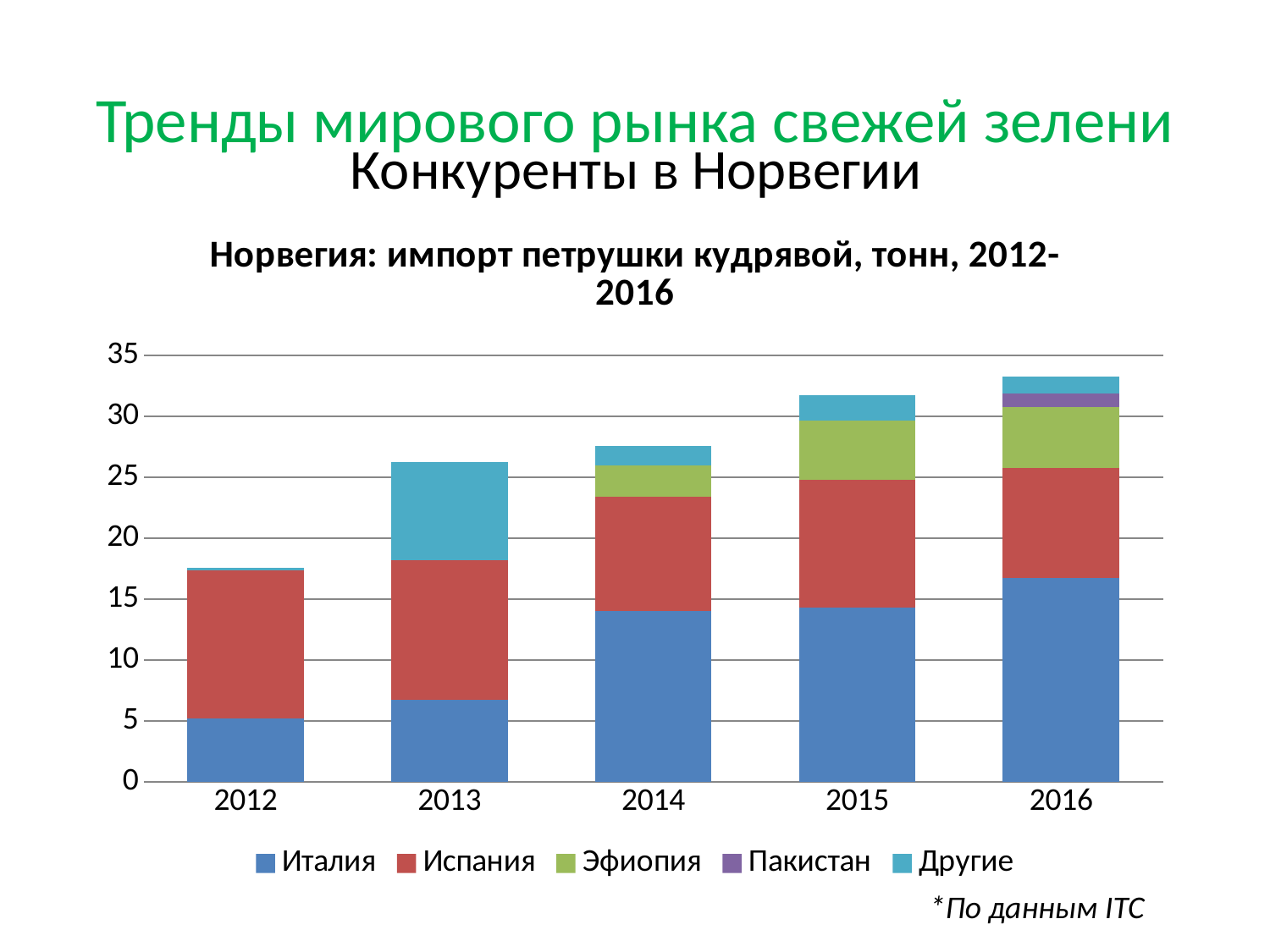
Is the total value for 2012 greater or less than 20? less Which is larger: the total for 2015 or the total for 2013? 2015 Which year has the lowest total import of curly parsley? 2012 Is the value for Италия in 2016 greater or less than 15? greater Do the values for Италия rise or fall from 2012 to 2016? rise How many years (categories) are shown on the x axis? 5 Which year has the highest total import of curly parsley? 2016 Is the total value for 2016 greater or less than 30? greater What kind of chart is shown on the slide? stacked bar chart How many series does the legend list? 5 What is the title of the chart? Норвегия: импорт петрушки кудрявой, тонн, 2012-2016